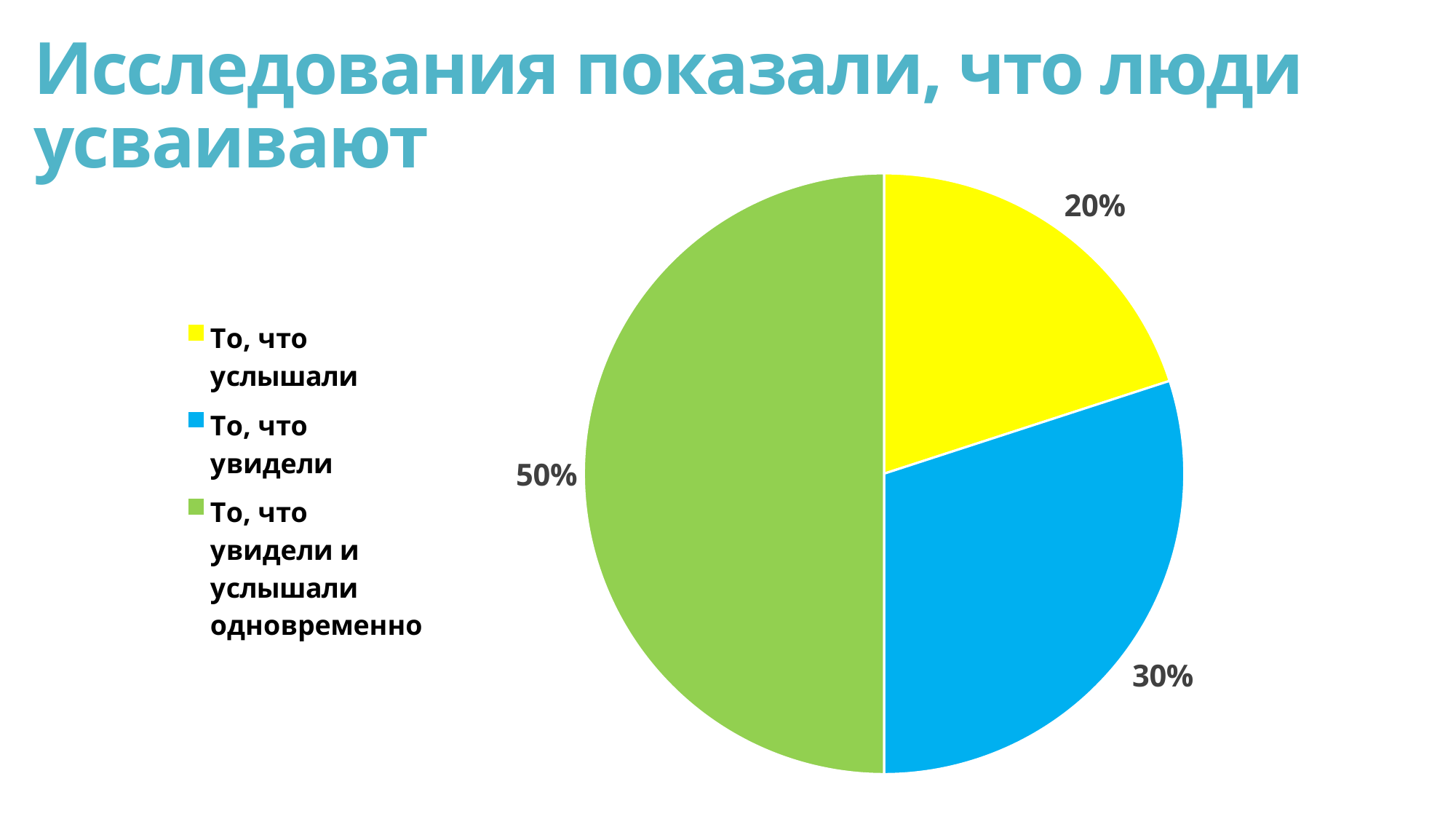
Which category has the largest slice of the pie? То, что увидели и услышали одновременно What percentage is shown for 'То, что услышали'? 20% What colour is the slice for 'То, что услышали'? yellow What percentage is shown for 'То, что увидели и услышали одновременно'? 50% What percentage is shown for 'То, что увидели'? 30% How many categories does the pie chart have? 3 What is the difference between the share for 'То, что увидели и услышали одновременно' and the share for 'То, что увидели'? 20% Which is larger: the slice for 'То, что увидели' or the slice for 'То, что услышали'? То, что увидели What colour is the slice for 'То, что увидели'? blue Which category has the smallest slice of the pie? То, что услышали What is the difference between the share for 'То, что увидели' and the share for 'То, что услышали'? 10% What kind of chart is shown on the slide? pie chart